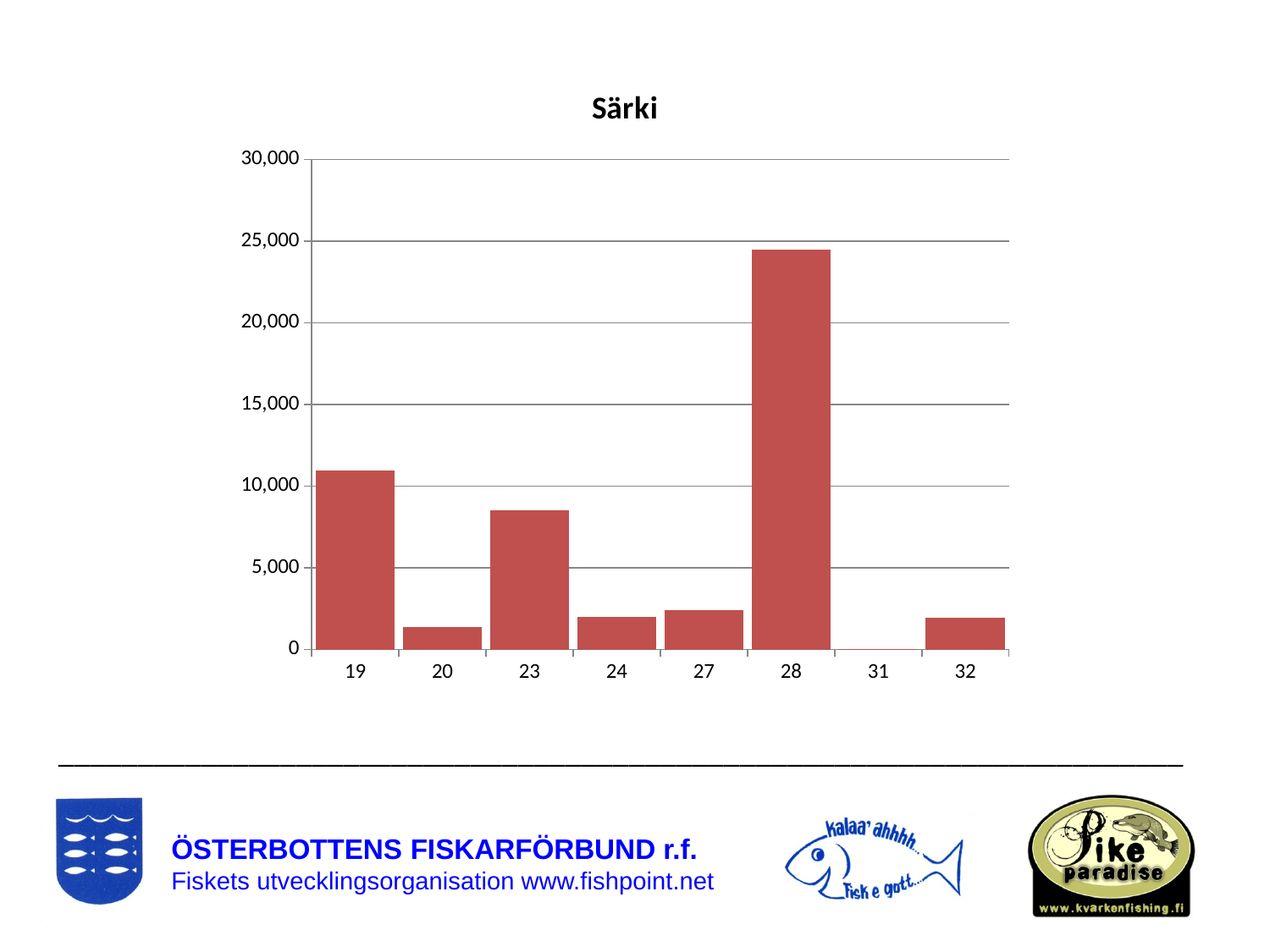
What colour are the bars in the chart? red Is the value for category 23 greater or less than 10,000? less What is the title of the chart? Särki Which has the larger value, category 19 or category 23? 19 Which has the larger value, category 23 or category 27? 23 Is the value for category 19 greater or less than 10,000? greater Which category has the lowest value in the chart? 31 Is the value for category 28 greater or less than 20,000? greater How many categories are shown on the x axis of the chart? 8 What kind of chart is shown on the slide? bar chart Which category has the highest value in the chart? 28